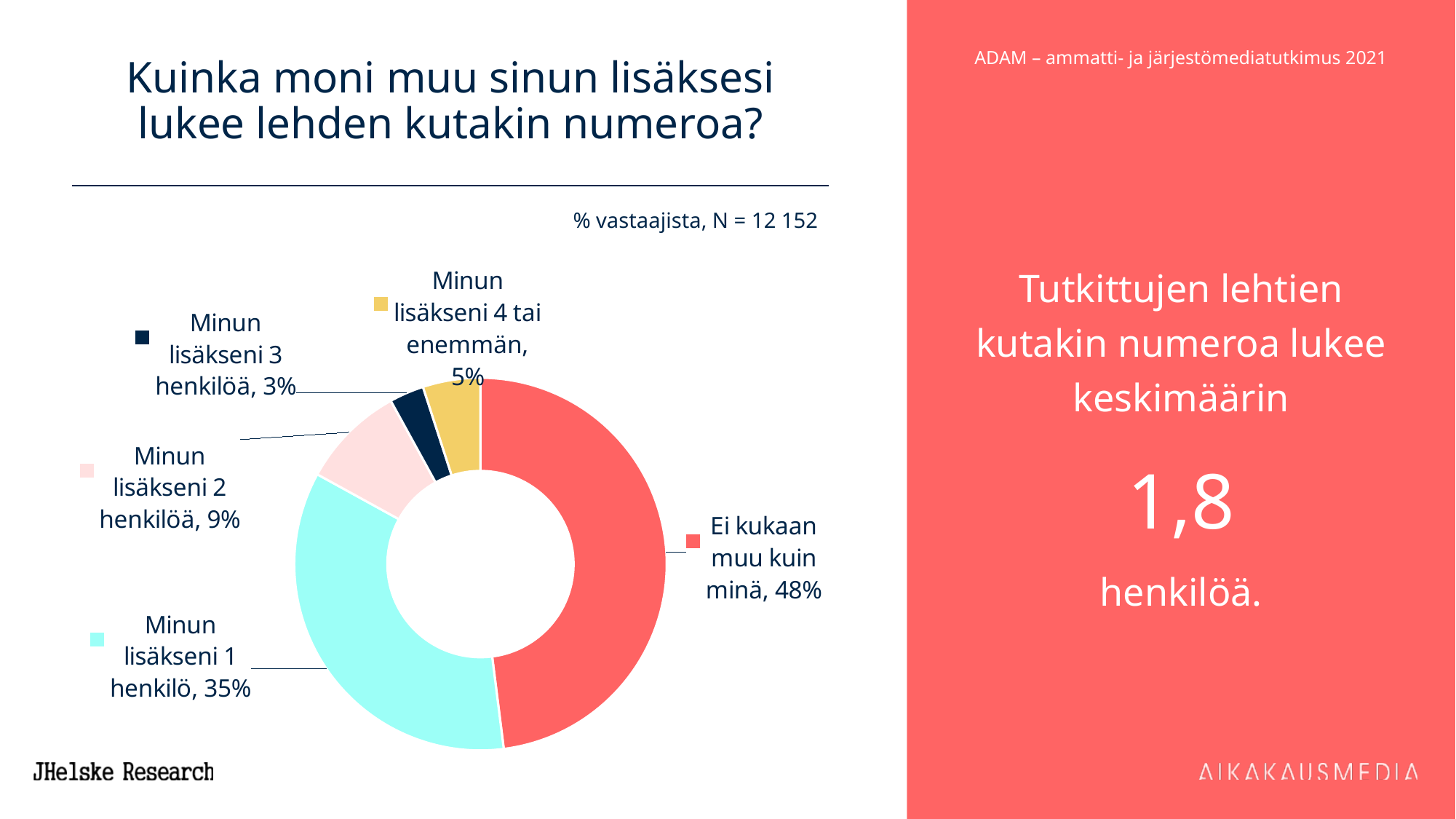
Which is larger: the share for "Minun lisäkseni 2 henkilöä" or for "Minun lisäkseni 4 tai enemmän"? Minun lisäkseni 2 henkilöä What share of respondents answered "Minun lisäkseni 1 henkilö"? 35% What share of respondents answered "Minun lisäkseni 4 tai enemmän"? 5% What kind of chart is shown on the slide? Pie chart (doughnut) What share of respondents answered "Ei kukaan muu kuin minä"? 48% Which category has the smallest share of the pie? Minun lisäkseni 3 henkilöä What is the number of respondents (N) stated above the chart? 12 152 What is the difference in percentage points between "Ei kukaan muu kuin minä" and "Minun lisäkseni 1 henkilö"? 13 What share of respondents answered "Minun lisäkseni 2 henkilöä"? 9% How many categories are shown in the chart? 5 Which category has the largest share of the pie? Ei kukaan muu kuin minä What share of respondents answered "Minun lisäkseni 3 henkilöä"? 3%